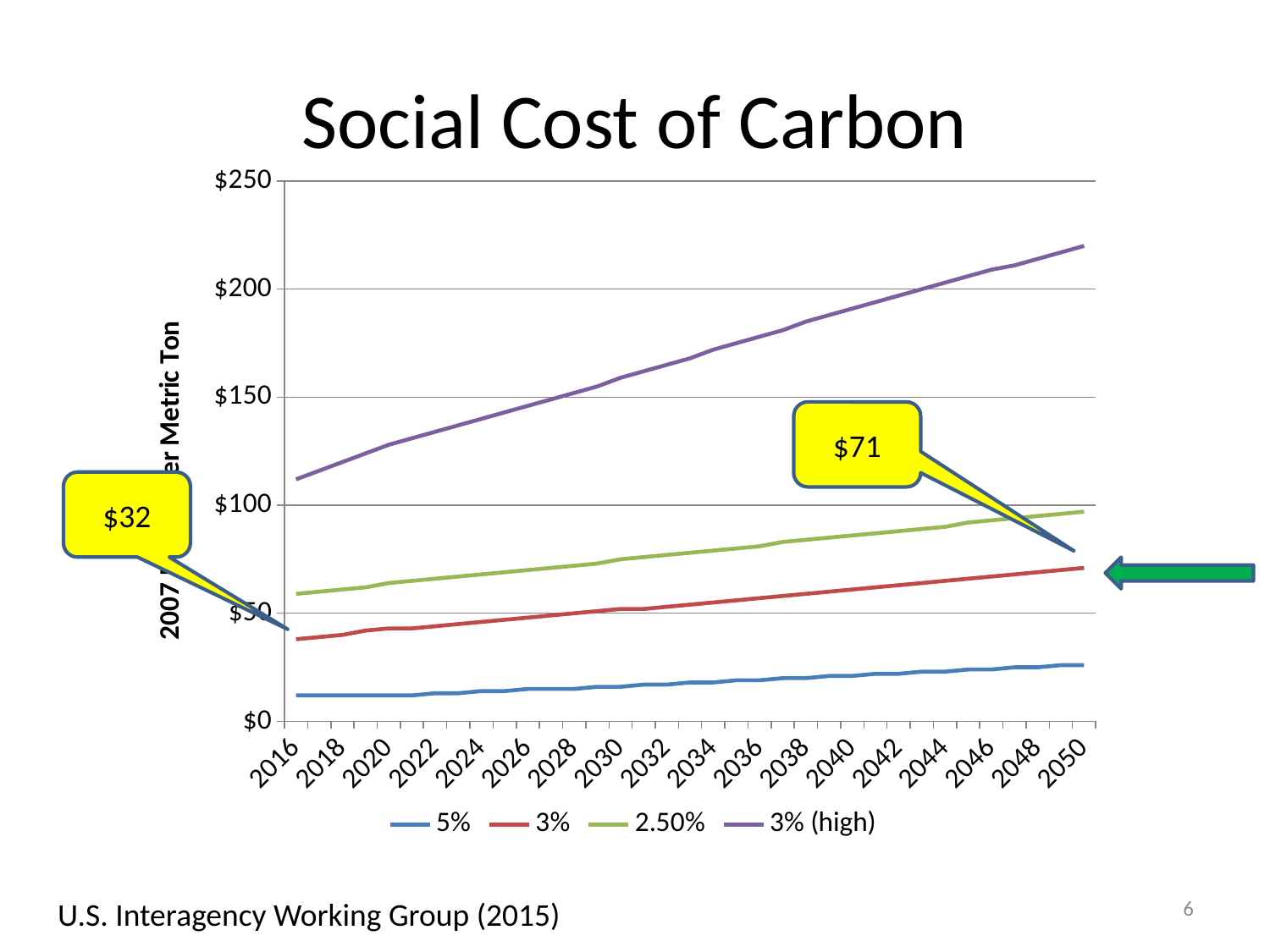
How many series does the legend list? 4 What kind of chart is shown on the slide? line chart Which series has the highest value in 2050? 3% (high) By how much does the 3% series increase from 2016 ($32) to 2050 ($71)? $39 Is the value for the 5% series in 2050 greater or less than $50? less Is the value for the 3% (high) series in 2050 greater or less than $200? greater In 2040, which series has the larger value, 2.50% or 3%? 2.50% What is the title of the chart? Social Cost of Carbon Which series has the lowest value across the years shown? 5% Do the values of the 3% (high) series rise or fall from 2016 to 2050? rise According to the callout, what is the value of the 3% series in 2050? $71 According to the callout, what is the value of the 3% series in 2016? $32